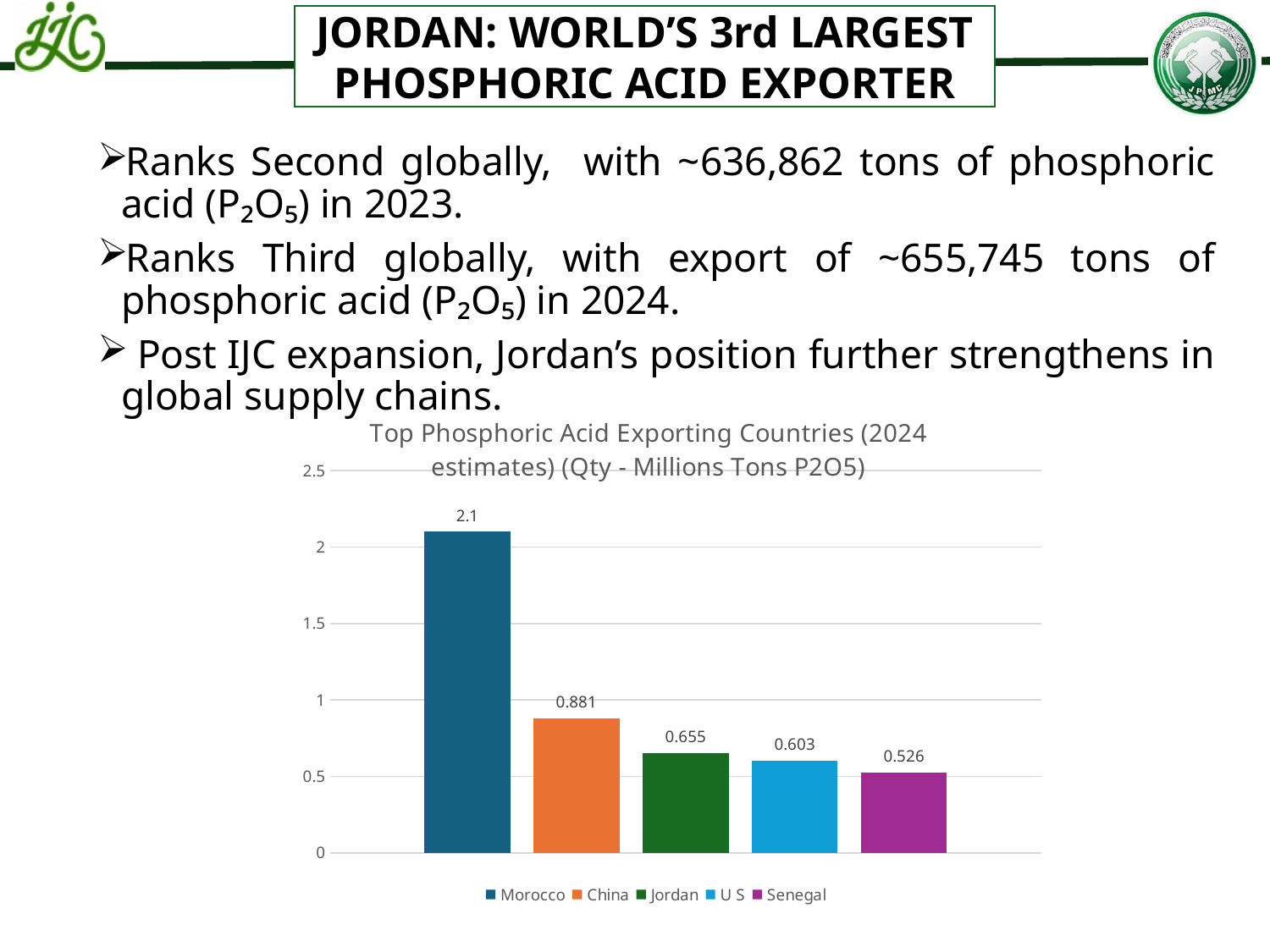
What is the value for Senegal in the chart? 0.526 What is the title of the chart? Top Phosphoric Acid Exporting Countries (2024 estimates) (Qty - Millions Tons P2O5) What is the value for China in the chart? 0.881 What is the difference between the values for Morocco and China? 1.219 Which country has the lowest value in the chart? Senegal Which country has the highest value in the chart? Morocco What is the value for Morocco in the chart? 2.1 What is the difference between the values for Jordan and U S? 0.052 How many countries are shown in the chart? 5 What kind of chart is shown on the slide? Bar chart What is the value for Jordan in the chart? 0.655 Which has a larger value, China or Jordan? China